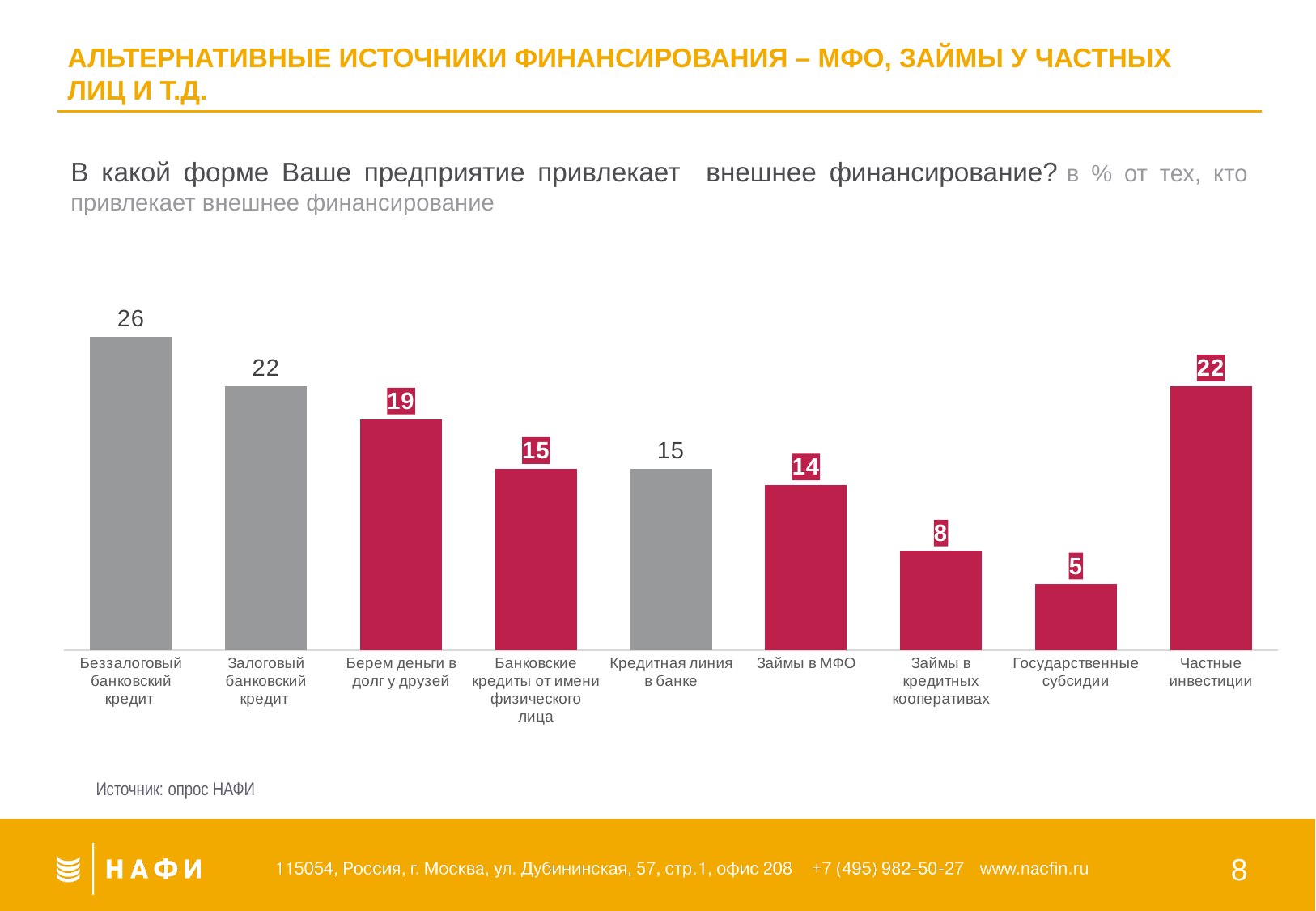
How many categories are shown in the chart? 9 What kind of chart is shown on the slide? Bar chart Which is larger, the value for Займы в МФО or the value for Займы в кредитных кооперативах? Займы в МФО What value is shown for Частные инвестиции? 22 What is the source cited below the chart? опрос НАФИ What value is shown for Берем деньги в долг у друзей? 19 What value is shown for Займы в МФО? 14 Which is larger, the value for Берем деньги в долг у друзей or the value for Кредитная линия в банке? Берем деньги в долг у друзей Which category has the highest value? Беззалоговый банковский кредит What is the difference between the values for Займы в кредитных кооперативах and Государственные субсидии? 3 What is the difference between the values for Беззалоговый банковский кредит and Залоговый банковский кредит? 4 Which category has the lowest value? Государственные субсидии